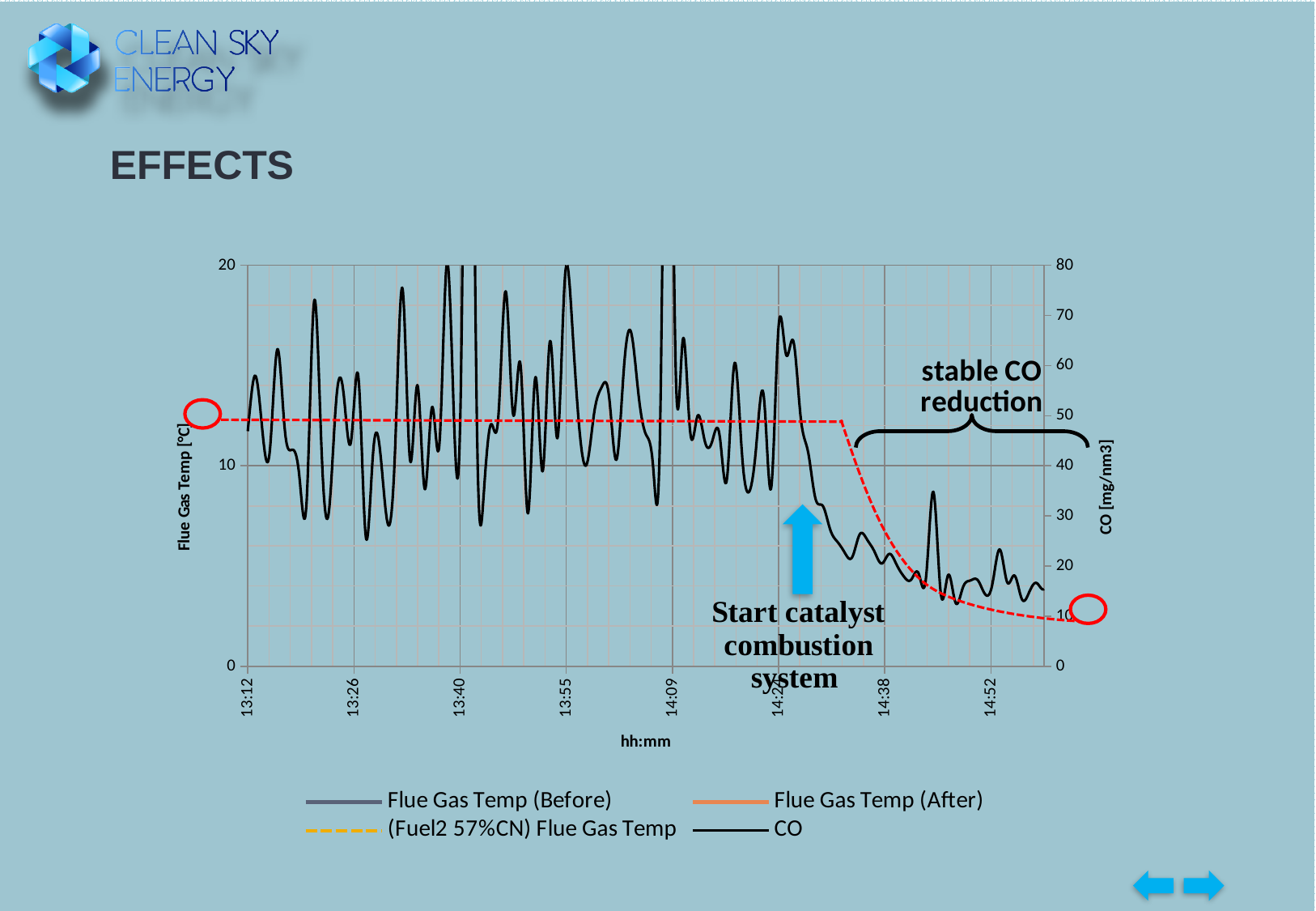
How many series does the legend list? 4 What is the title of the right-hand vertical axis? CO [mg/nm3] What event does the blue arrow annotation on the chart mark? Start catalyst combustion system Does the CO value rise or fall along the x axis between 14:23 and 14:52? fall Is the CO value at 14:52 greater or less than 40 mg/nm3? less Is the CO value at 14:52 greater or less than 10 mg/nm3? greater What kind of chart is shown on the slide? line chart Is the CO value at 14:38 greater or less than 40 mg/nm3? less